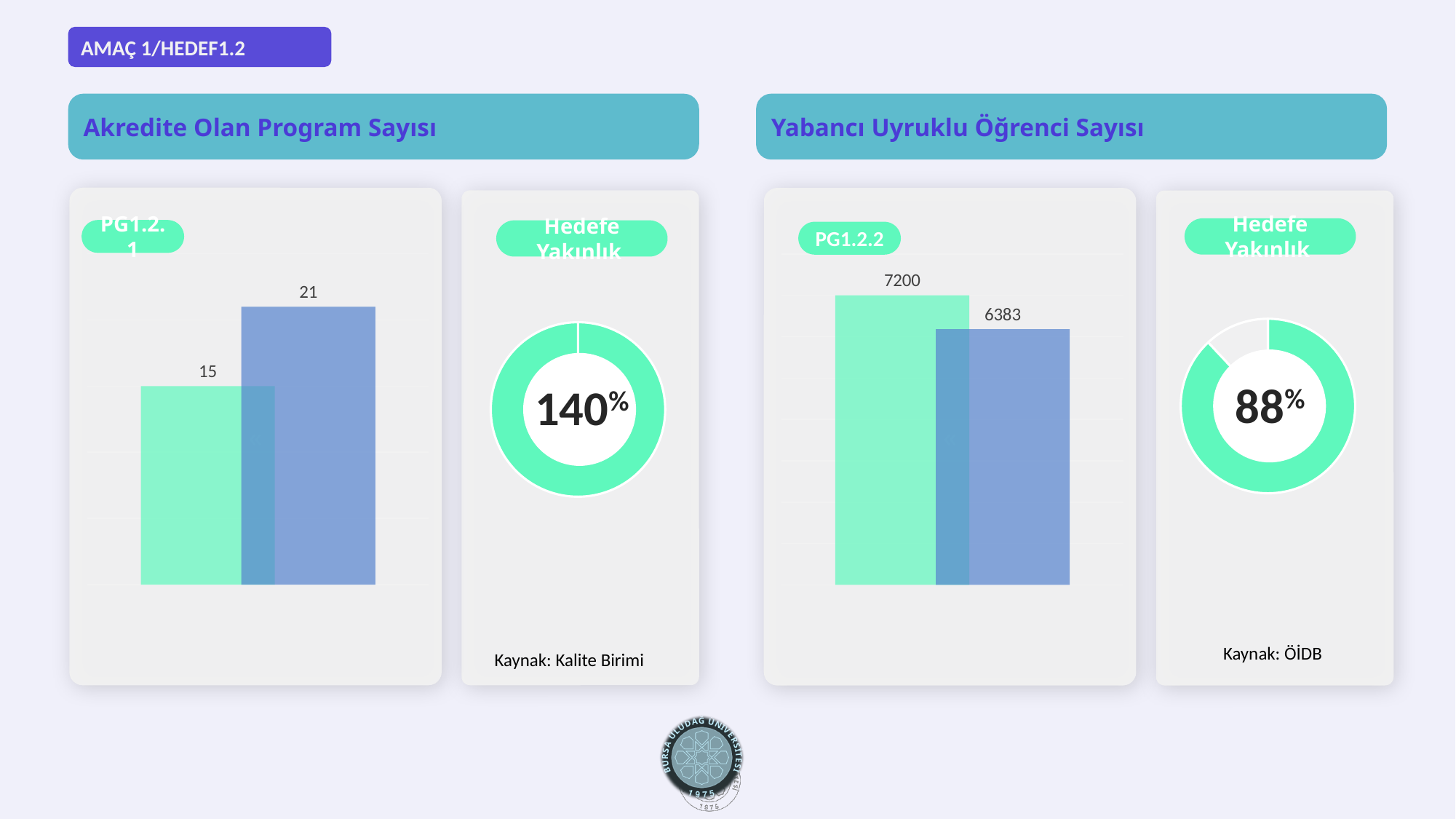
In the 'Yabancı Uyruklu Öğrenci Sayısı' bar chart, which bar is higher, the green one or the blue one? the green one What percentage is shown in the 'Hedefe Yakınlık' donut chart under 'Yabancı Uyruklu Öğrenci Sayısı'? 88% What kind of chart is used to show the 'Hedefe Yakınlık' values on the slide? donut chart In the 'Yabancı Uyruklu Öğrenci Sayısı' bar chart, what value is shown on the blue bar? 6383 How many bars are in the 'Yabancı Uyruklu Öğrenci Sayısı' bar chart? 2 What percentage is shown in the 'Hedefe Yakınlık' donut chart under 'Akredite Olan Program Sayısı'? 140% In the 'Akredite Olan Program Sayısı' bar chart, which bar is higher, the green one or the blue one? the blue one In the 'Akredite Olan Program Sayısı' bar chart, what is the difference between the blue bar and the green bar? 6 In the 'Yabancı Uyruklu Öğrenci Sayısı' bar chart, what value is shown on the green bar? 7200 In the 'Akredite Olan Program Sayısı' bar chart, what value is shown on the green bar? 15 In the 'Yabancı Uyruklu Öğrenci Sayısı' bar chart, what is the difference between the green bar and the blue bar? 817 In the 'Akredite Olan Program Sayısı' bar chart, what value is shown on the blue bar? 21